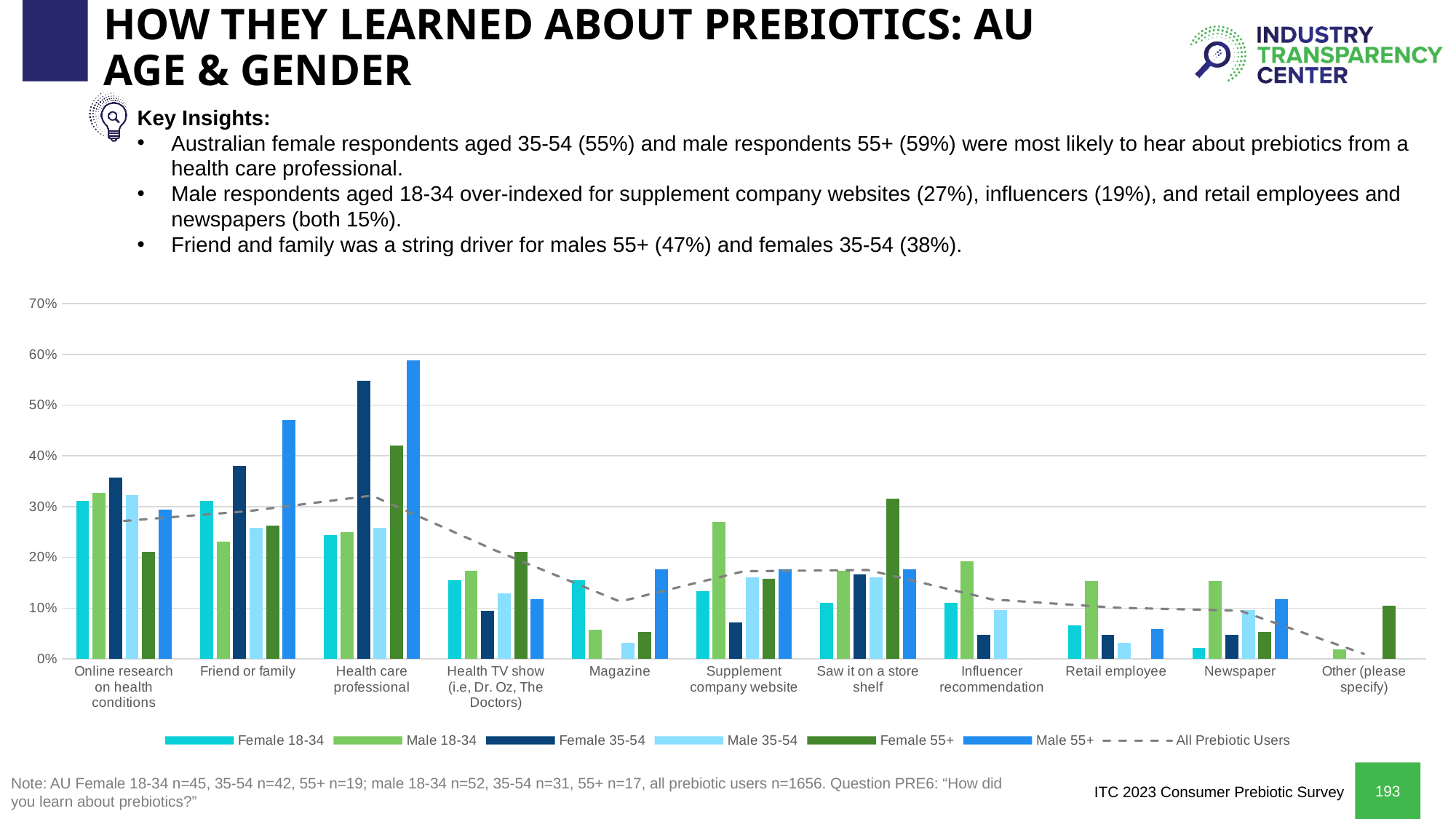
Within the Health care professional category, which series has the highest value? Male 55+ Within the Online research on health conditions category, which series has the lowest value? Female 55+ Is the Male 35-54 value for Magazine greater or less than 10%? less How many categories are shown along the x axis of the chart? 11 Does the All Prebiotic Users dashed line generally rise or fall from Health care professional to Other (please specify)? Fall Is the Male 18-34 value for Supplement company website greater or less than 20%? greater How many series does the chart legend list? 7 What kind of chart is shown on the slide? Combination bar and line chart Is the Male 55+ value for Health care professional greater or less than 50%? greater Which category has the tallest bar in the chart? Health care professional Which series in the legend is drawn as a dashed line rather than bars? All Prebiotic Users For Friend or family, which is larger: the Male 55+ value or the Female 35-54 value? Male 55+